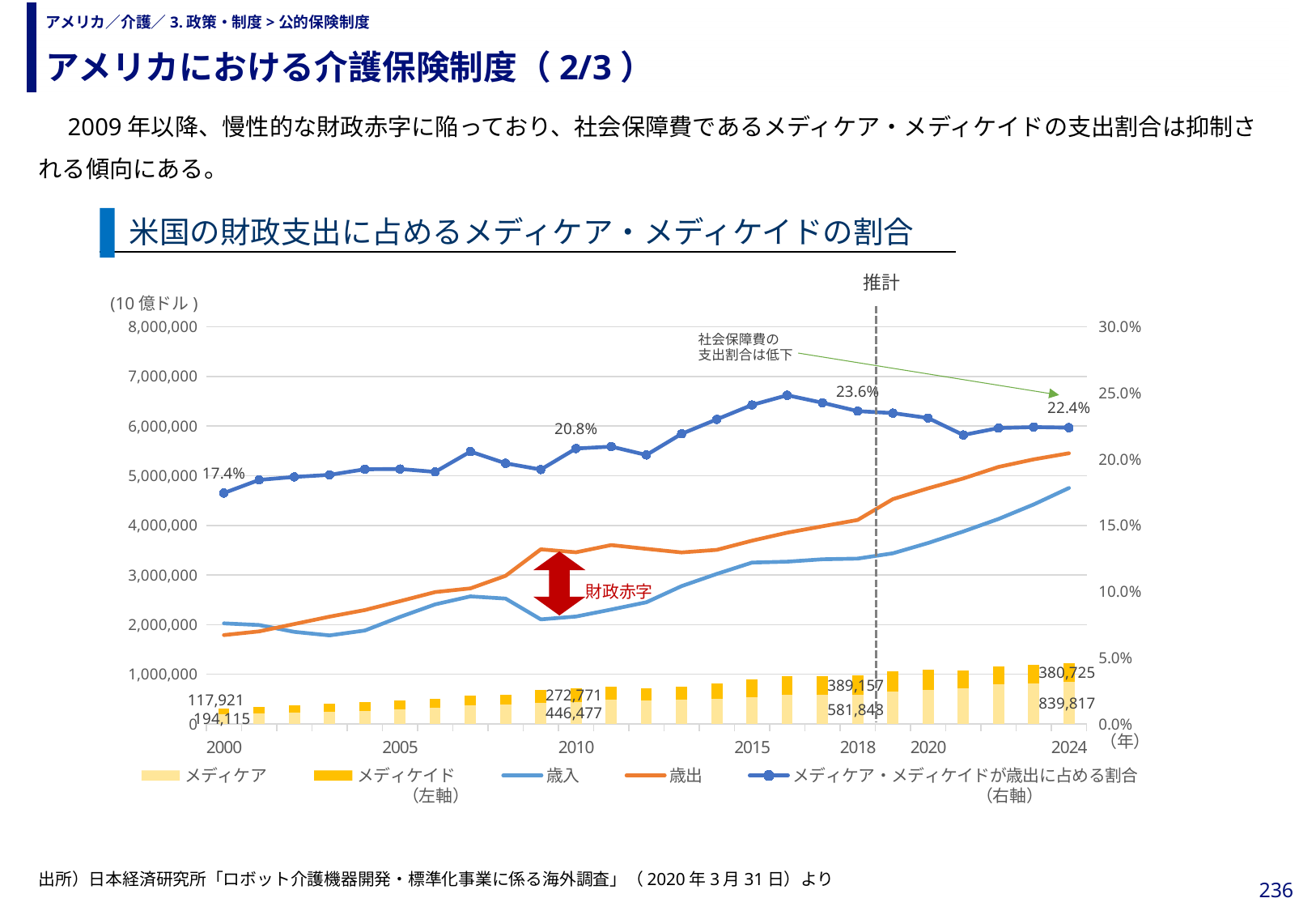
What type of chart is shown on the slide? Combination bar and line chart What is the value of メディケア・メディケイドが歳出に占める割合 in 2000? 17.4% What is the value of メディケア in 2024? 839,817 What is the value of メディケイド in 2018? 389,157 Is the value for 歳出 in 2024 greater or less than 5,000,000? greater How many series does the legend list? 5 What is the combined total of メディケア and メディケイド in 2000? 312,036 In 2024, which is larger, 歳入 or 歳出? 歳出 By how many percentage points does メディケア・メディケイドが歳出に占める割合 in 2024 exceed the value in 2000? 5.0% In which year is メディケア・メディケイドが歳出に占める割合 at its lowest? 2000 Does the 歳出 line generally rise or fall from 2000 to 2024? rise What is the value of メディケア・メディケイドが歳出に占める割合 in 2024? 22.4%